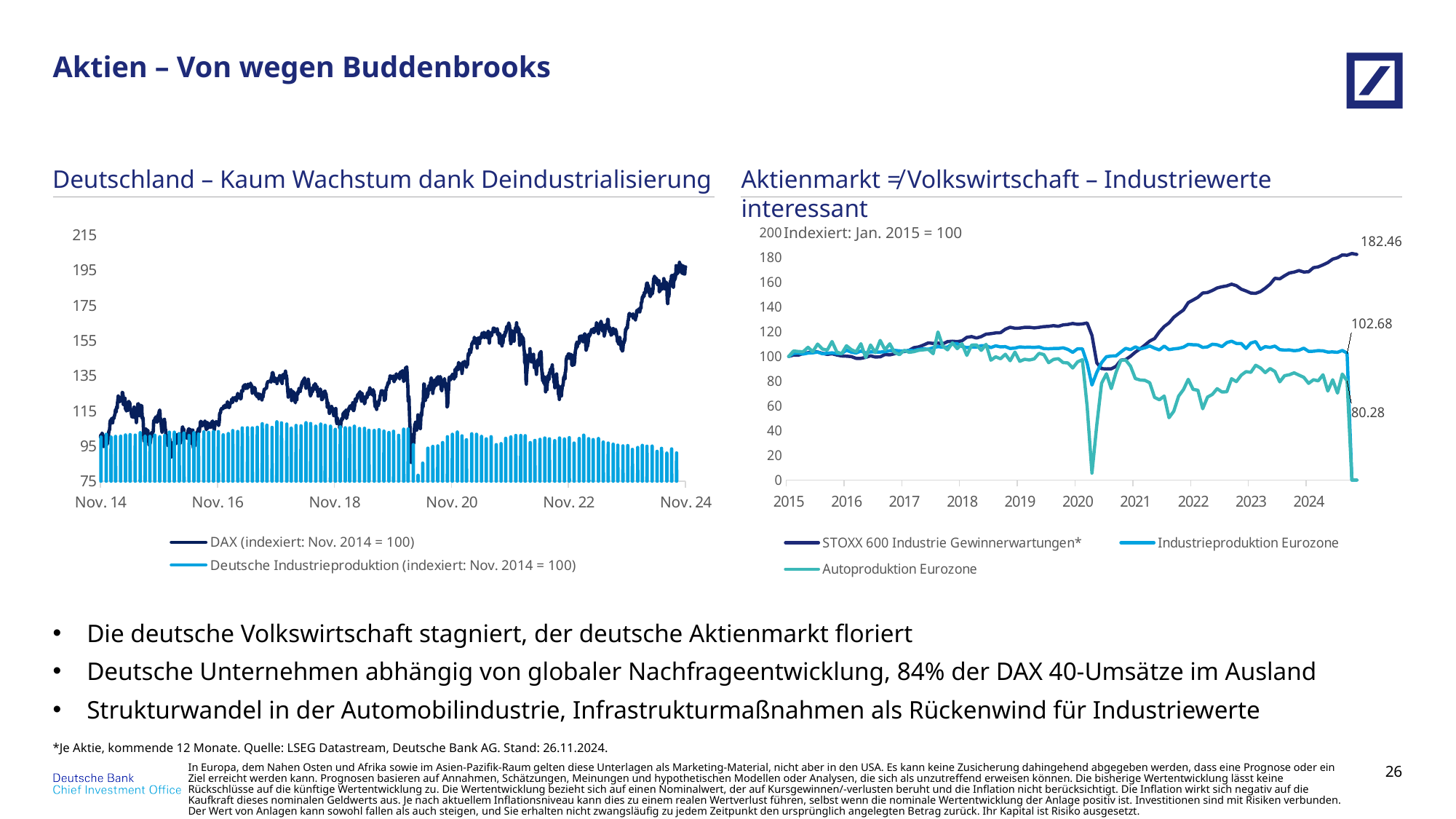
In the right chart, what is the labelled end value of Industrieproduktion Eurozone? 102.68 In the right chart, what is the difference between the labelled end values of Industrieproduktion Eurozone (102.68) and Autoproduktion Eurozone (80.28)? 22.40 How many series does the legend of the right chart list? 3 In the left chart, is the DAX value at Nov. 24 greater or less than 175? greater In the right chart, what index base is stated below the title? Indexiert: Jan. 2015 = 100 In the right chart, what is the difference between the labelled end values of STOXX 600 Industrie Gewinnerwartungen* (182.46) and Industrieproduktion Eurozone (102.68)? 79.78 What kind of chart is the right chart (Aktienmarkt ≠ Volkswirtschaft)? line chart In the right chart, what is the labelled end value of Autoproduktion Eurozone? 80.28 In the left chart, does the DAX line overall rise or fall from Nov. 14 to Nov. 24? rise In the right chart, which series has the highest labelled end value? STOXX 600 Industrie Gewinnerwartungen* In the right chart (Aktienmarkt ≠ Volkswirtschaft), what is the labelled end value of the STOXX 600 Industrie Gewinnerwartungen* series? 182.46 How many series does the legend of the left chart (Deutschland – Kaum Wachstum dank Deindustrialisierung) list? 2